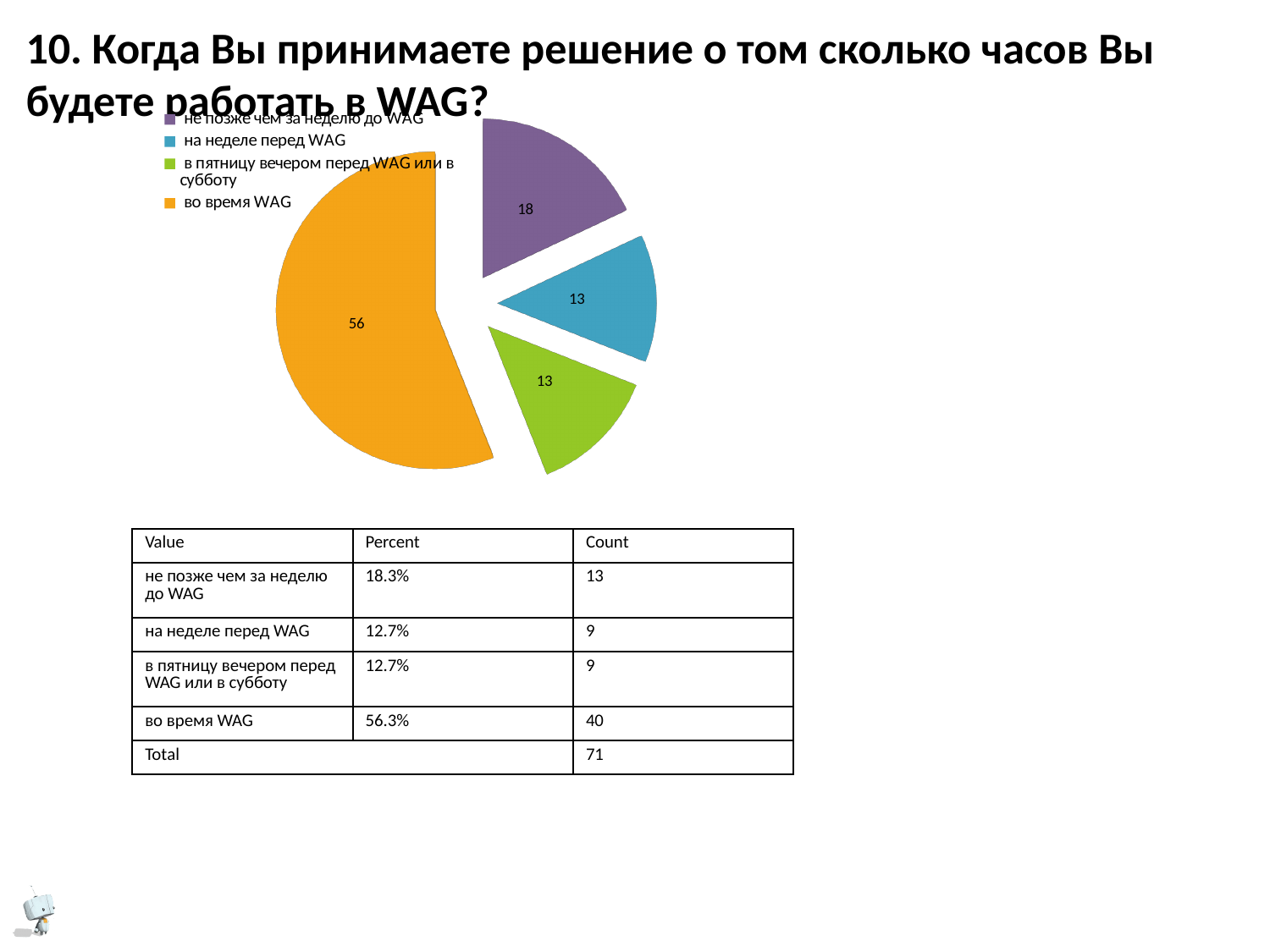
How many entries does the legend of the pie chart list? 4 What is the difference between the labelled values for 'во время WAG' and 'не позже чем за неделю до WAG' in the pie chart? 38 What colour is the slice for 'на неделе перед WAG' in the pie chart? blue What kind of chart is shown on the slide? pie chart How many slices does the pie chart have? 4 What value is labelled on the pie slice for 'во время WAG'? 56 Which category has the largest slice in the pie chart? во время WAG What colour is the slice for 'во время WAG' in the pie chart? orange Which is larger in the pie chart: the slice for 'не позже чем за неделю до WAG' or the slice for 'на неделе перед WAG'? не позже чем за неделю до WAG What value is labelled on the pie slice for 'в пятницу вечером перед WAG или в субботу'? 13 What value is labelled on the pie slice for 'не позже чем за неделю до WAG'? 18 What value is labelled on the pie slice for 'на неделе перед WAG'? 13